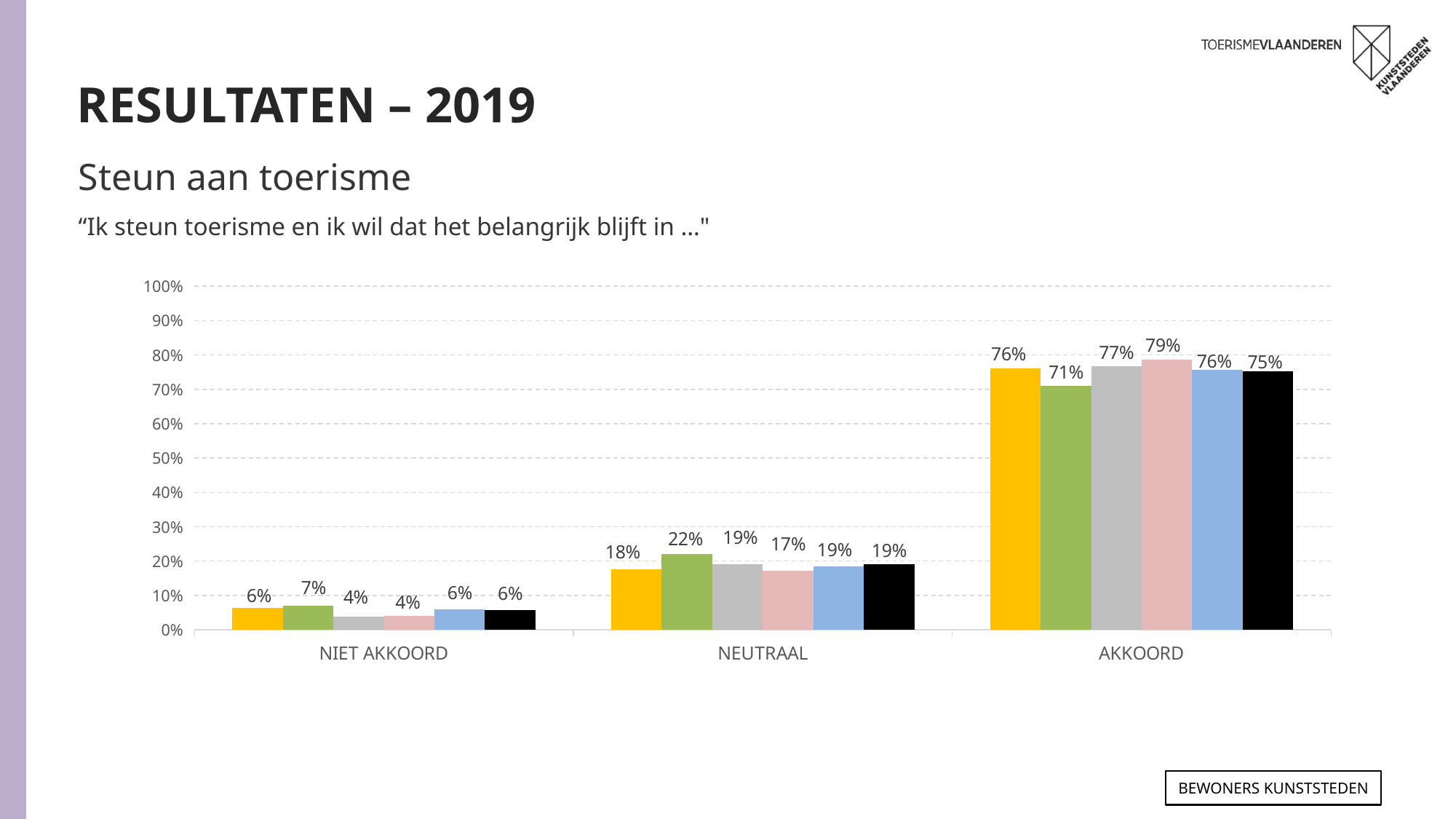
What kind of chart is shown on the slide? bar chart Which bar has the highest value in the AKKOORD category? the pink bar (79%) What is the value of the black bar for AKKOORD? 75% What is the value of the green bar for NEUTRAAL? 22% Is the value of the grey bar for AKKOORD greater or less than 70%? greater How many categories are shown on the x axis of the chart? 3 What is the value of the pink bar for NIET AKKOORD? 4% How many bars are shown for each category on the x axis? 6 What is the difference between the pink bar and the green bar in the AKKOORD category? 8% What is the value of the yellow bar for AKKOORD? 76% Which bar has the lowest value in the AKKOORD category? the green bar (71%) Which is larger in the NEUTRAAL category: the green bar or the pink bar? the green bar